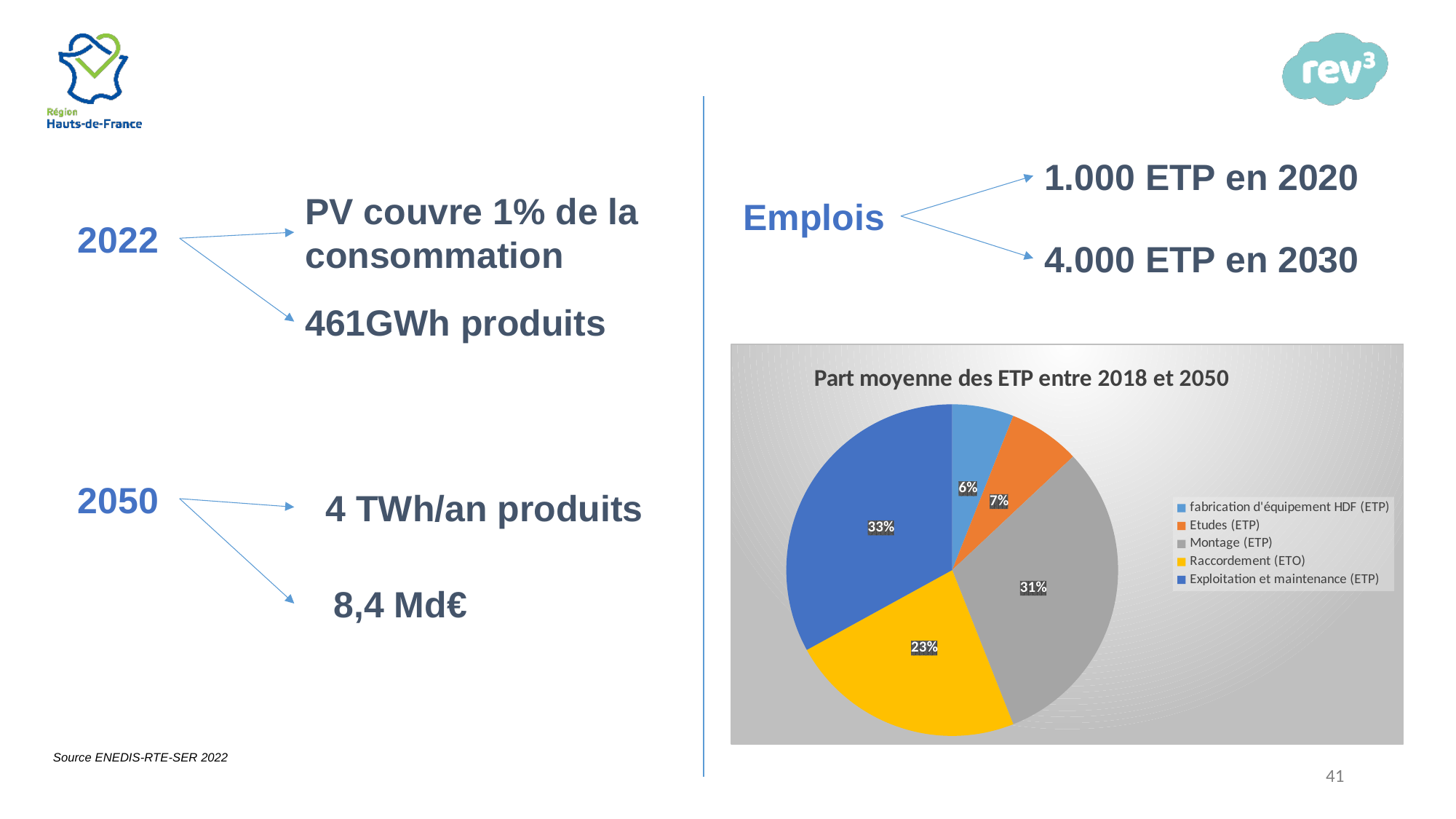
Which category has the smallest share in the pie chart? fabrication d'équipement HDF (ETP) Which is larger in the pie chart, the share of Raccordement (ETO) or the share of Etudes (ETP)? Raccordement (ETO) What is the difference between the shares of Montage (ETP) and Raccordement (ETO)? 8% What kind of chart is shown on the slide? pie chart Which category has the largest share in the pie chart? Exploitation et maintenance (ETP) What share does Raccordement (ETO) have in the pie chart? 23% What share does Exploitation et maintenance (ETP) have in the pie chart? 33% What share does Etudes (ETP) have in the pie chart? 7% What is the title of the chart? Part moyenne des ETP entre 2018 et 2050 What share does Montage (ETP) have in the pie chart? 31% What share does fabrication d'équipement HDF (ETP) have in the pie chart? 6% How many categories does the legend of the pie chart list? 5